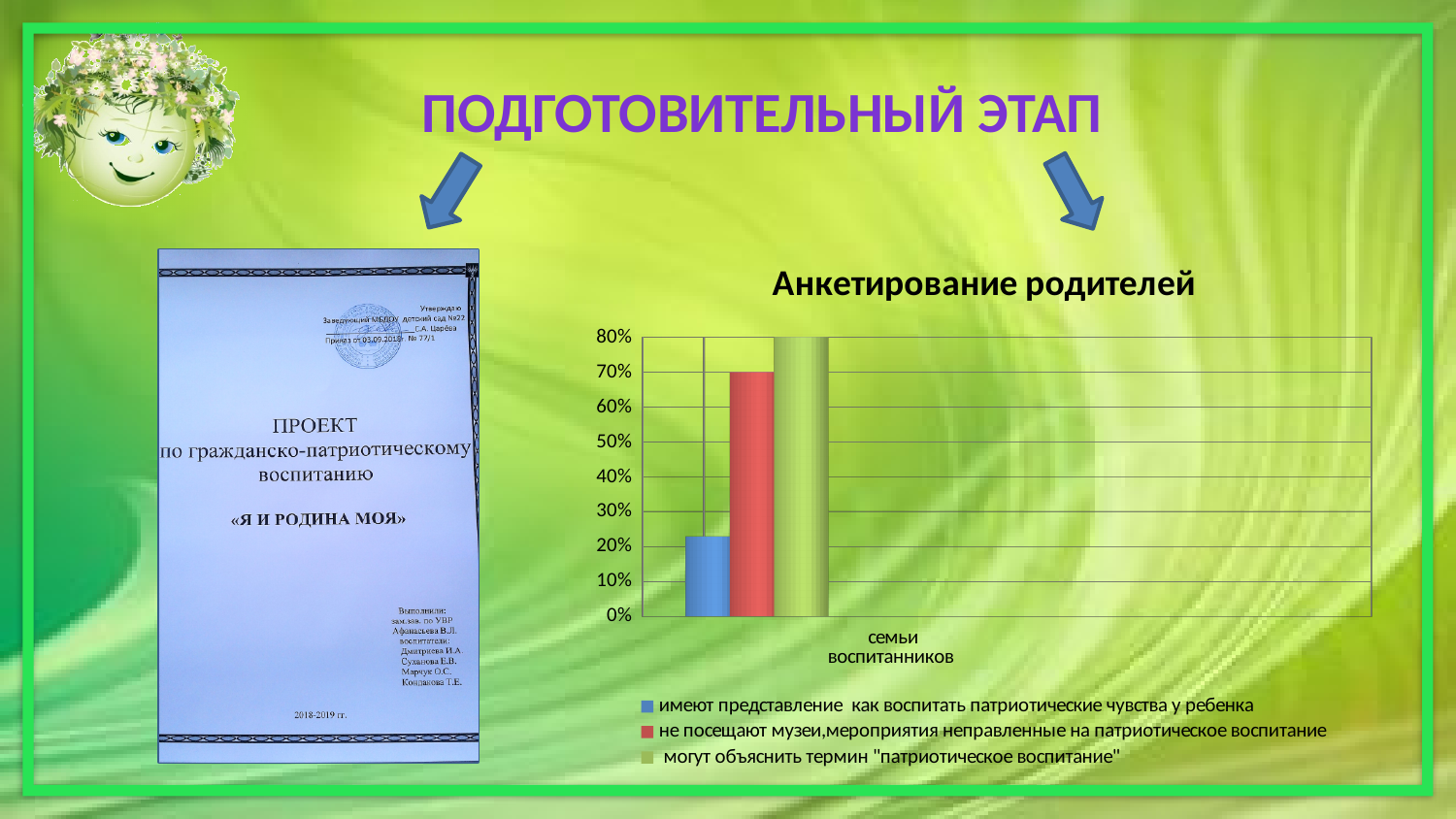
Which series has the lowest value in the "Анкетирование родителей" chart? имеют представление как воспитать патриотические чувства у ребенка In the "Анкетирование родителей" chart, is the value for "имеют представление как воспитать патриотические чувства у ребенка" greater or less than 20%? greater In the "Анкетирование родителей" chart, what is the difference between the value for "могут объяснить термин "патриотическое воспитание"" and the value for "не посещают музеи,мероприятия неправленные на патриотическое воспитание"? 10% In the "Анкетирование родителей" chart, is the value for "имеют представление как воспитать патриотические чувства у ребенка" greater or less than 30%? less What kind of chart is shown under the heading "Анкетирование родителей"? bar chart How many categories are shown on the x axis of the "Анкетирование родителей" chart? 1 In the "Анкетирование родителей" chart, what is the value for "могут объяснить термин "патриотическое воспитание""? 80% In the "Анкетирование родителей" chart, what is the value for "не посещают музеи,мероприятия неправленные на патриотическое воспитание"? 70% What is the category label on the x axis of the "Анкетирование родителей" chart? семьи воспитанников In the "Анкетирование родителей" chart, which is larger: the value for "не посещают музеи,мероприятия неправленные на патриотическое воспитание" or the value for "могут объяснить термин "патриотическое воспитание""? могут объяснить термин "патриотическое воспитание" How many series does the legend of the "Анкетирование родителей" chart list? 3 Which series has the highest value in the "Анкетирование родителей" chart? могут объяснить термин "патриотическое воспитание"